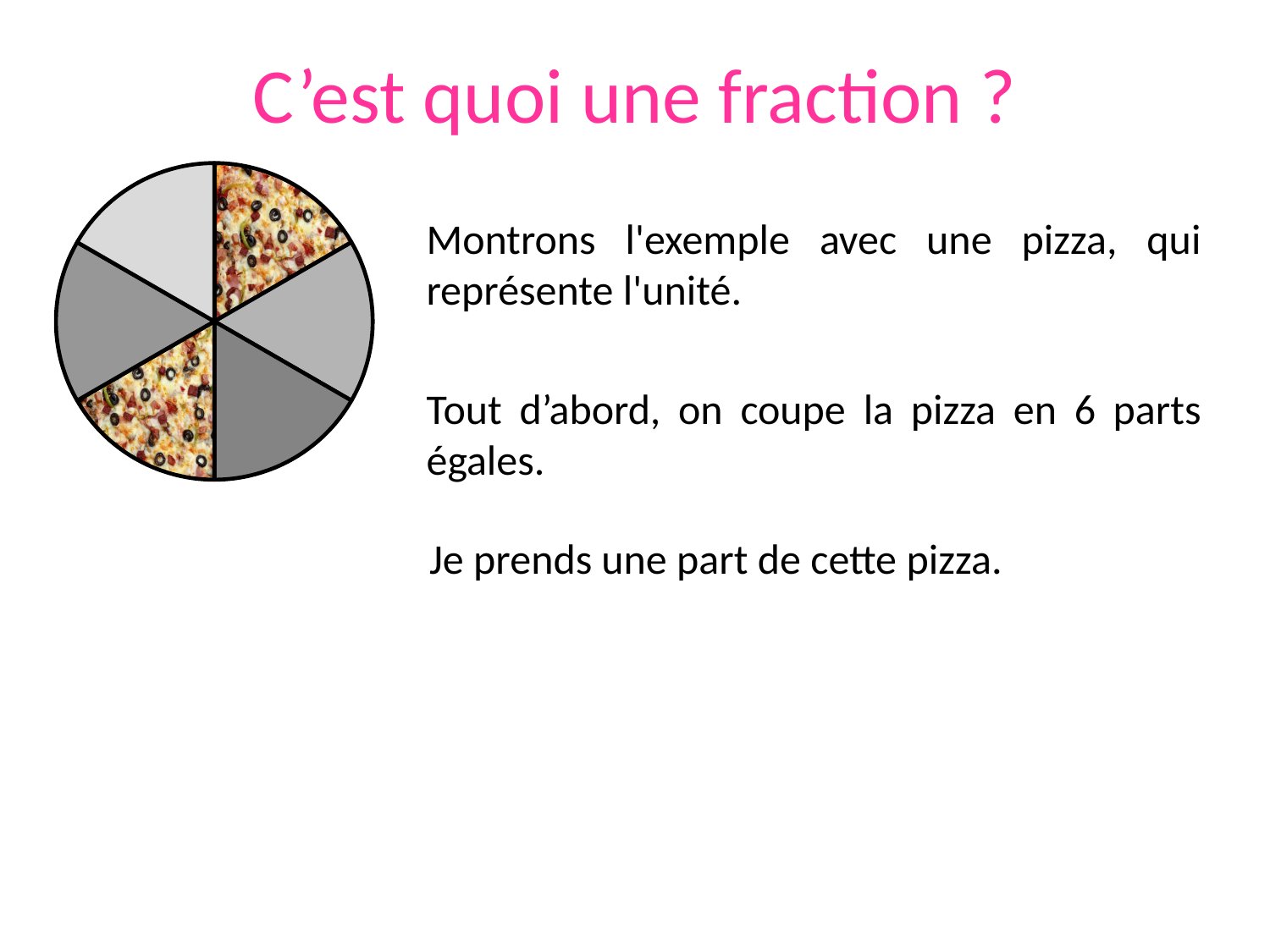
What kind of chart is shown on the left of the slide? pie chart How many slices is the pie chart divided into? 6 What fraction of the whole pie does one slice represent? 1/6 How many slices of the pie chart are shaded grey? 4 How many slices of the pie chart show the pizza image? 2